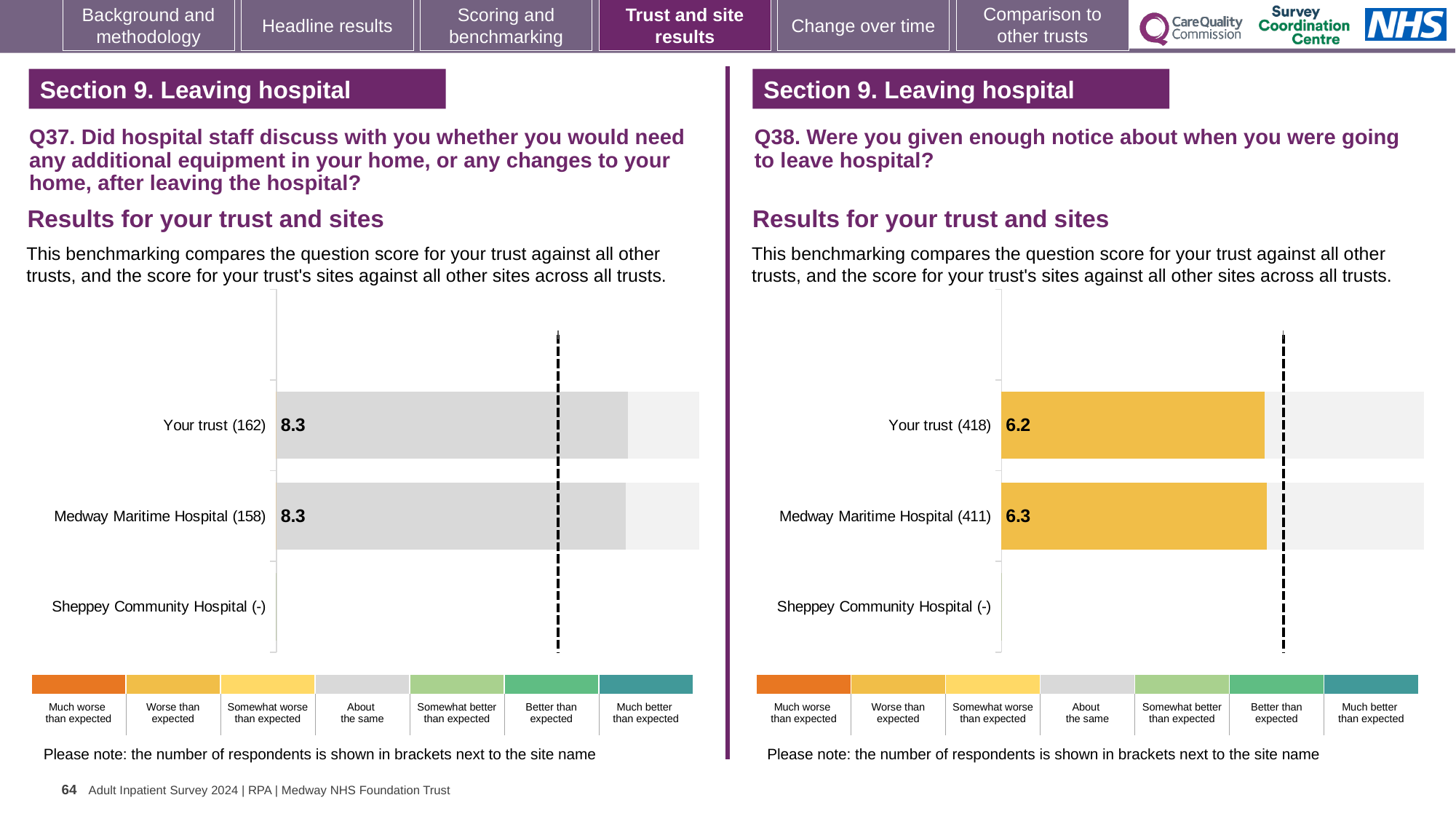
In the Q38 chart on the right, what is the difference between the Medway Maritime Hospital score and the Your trust score? 0.1 In the Q38 chart on the right, what is the score for Your trust? 6.2 In the Q38 chart on the right, which category has no score shown? Sheppey Community Hospital What kind of chart is used for the Q38 results on the right? Bar chart In the Q37 chart on the left, is the score for Your trust greater or less than the score for Your trust in the Q38 chart on the right? greater In the Q37 chart on the left, what is the score for Medway Maritime Hospital? 8.3 In the Q37 chart on the left, what is the score for Your trust? 8.3 In the Q38 chart on the right, which benchmark category does the colour of the Your trust bar correspond to in the legend? Worse than expected How many site/trust categories are listed on the y axis of the Q37 chart on the left? 3 In the Q38 chart on the right, what is the score for Medway Maritime Hospital? 6.3 In the Q37 chart on the left, how many respondents are shown in brackets for Your trust? 162 In the Q38 chart on the right, how many respondents are shown in brackets for Medway Maritime Hospital? 411